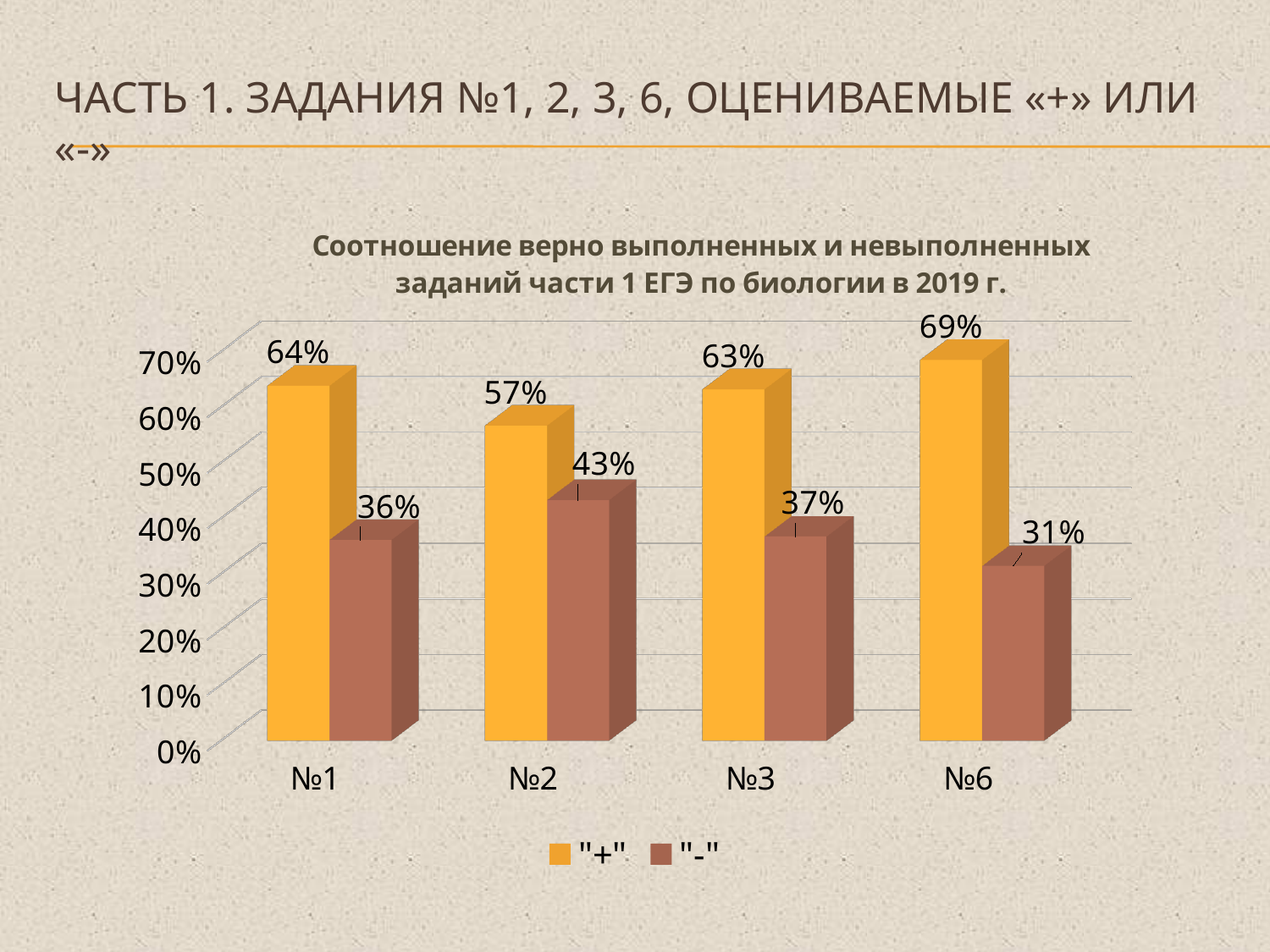
What is the title of the chart? Соотношение верно выполненных и невыполненных заданий части 1 ЕГЭ по биологии в 2019 г. What is the "+" value for №1? 64% Which task has the highest "+" value? №6 What is the difference between the "+" and "-" values for №2? 14% What is the "-" value for №2? 43% Which task has the lowest "-" value? №6 How many tasks (categories) are shown on the x axis? 4 What is the "+" value for №6? 69% What kind of chart is shown on the slide? Bar chart How many series does the legend list? 2 Which is larger: the "-" value for №1 or the "-" value for №2? №2 What is the "-" value for №3? 37%